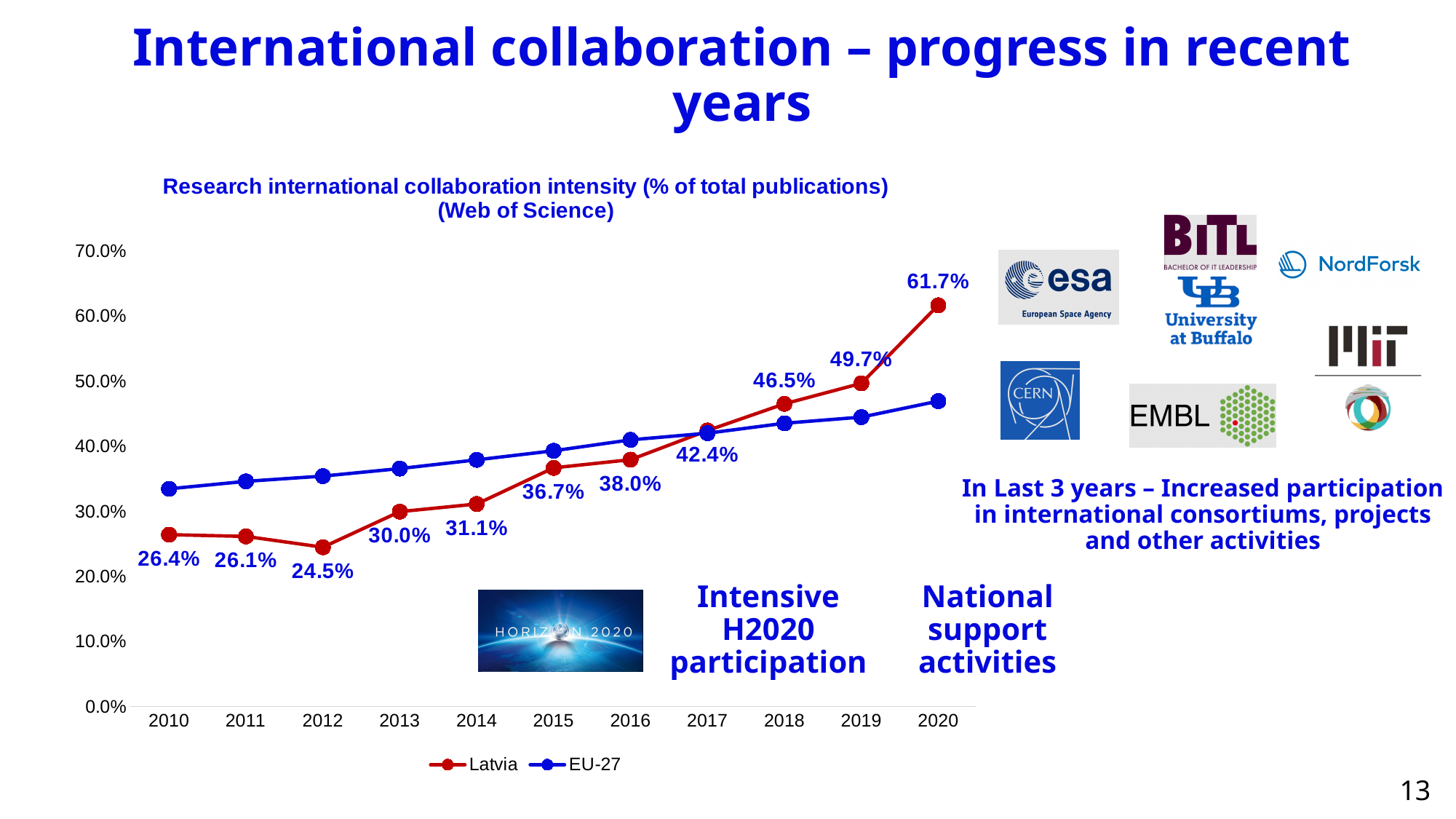
Which is larger for Latvia, the 2015 value or the 2016 value? 2016 How many years are shown on the x axis? 11 What is the Latvia value for 2020? 61.7% In which year is the Latvia value lowest? 2012 What kind of chart is shown? Line chart Is the EU-27 value for 2020 greater or less than 40.0%? greater In which year is the Latvia value highest? 2020 What is the Latvia value for 2017? 42.4% How many series does the legend list? 2 What is the difference between the Latvia values for 2020 and 2019? 12.0% Is the EU-27 value for 2010 greater or less than 40.0%? less What is the Latvia value for 2012? 24.5%